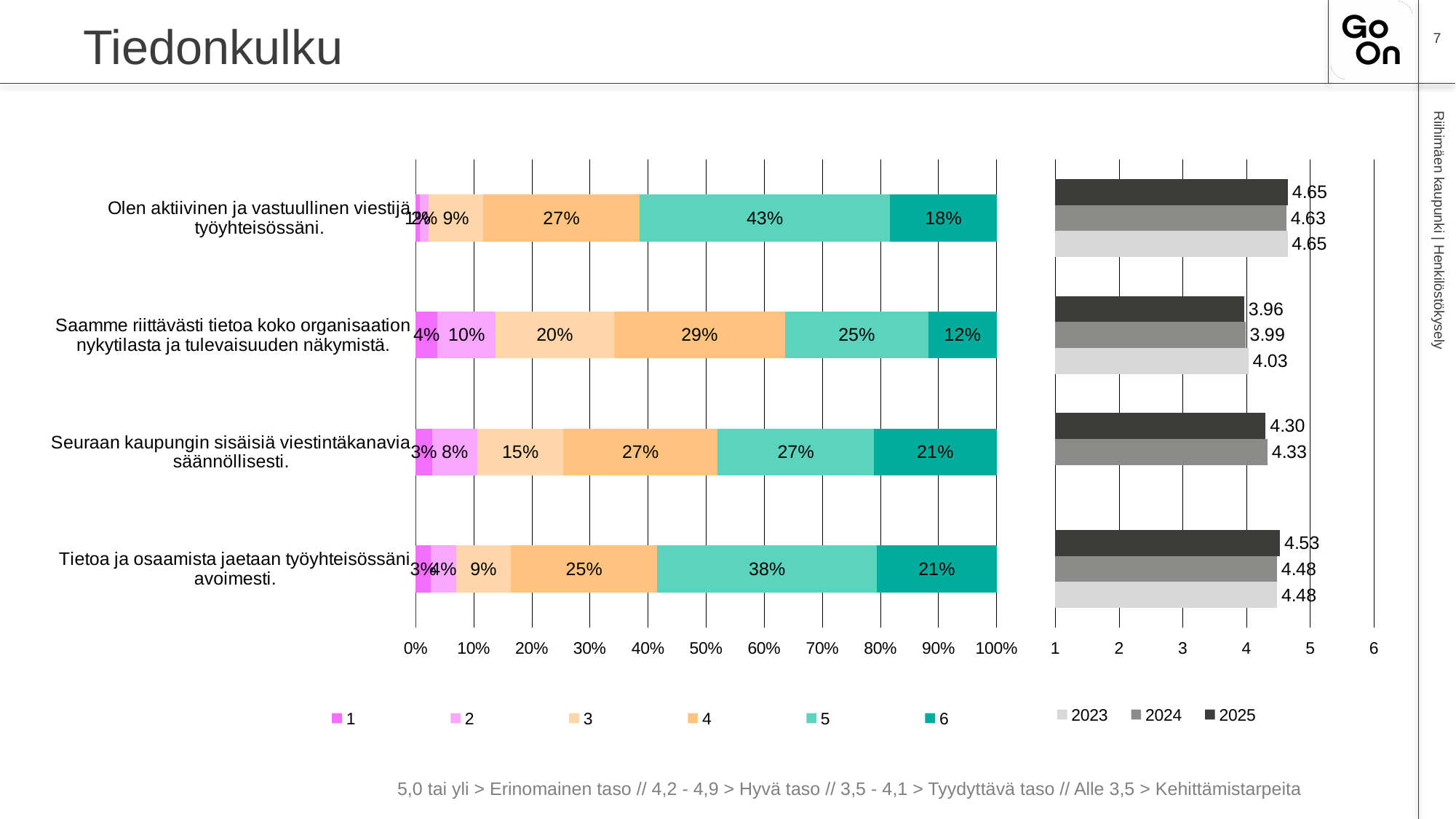
In the right bar chart, what is the 2025 value for "Saamme riittävästi tietoa koko organisaation nykytilasta ja tulevaisuuden näkymistä"? 3.96 In the left stacked bar chart, what percentage gave a rating of 6 for "Saamme riittävästi tietoa koko organisaation nykytilasta ja tulevaisuuden näkymistä"? 12% In the right bar chart, what is the difference between the 2025 and 2024 values for "Tietoa ja osaamista jaetaan työyhteisössäni avoimesti"? 0.05 In the left stacked bar chart, for "Saamme riittävästi tietoa koko organisaation nykytilasta ja tulevaisuuden näkymistä", which rating has the larger share: 4 or 5? 4 How many series does the legend of the left stacked bar chart list? 6 How many series does the legend of the right bar chart list? 3 In the left stacked bar chart, which statement has the highest share of rating 5? Olen aktiivinen ja vastuullinen viestijä työyhteisössäni. In the right bar chart, which statement has the lowest 2025 value? Saamme riittävästi tietoa koko organisaation nykytilasta ja tulevaisuuden näkymistä. In the left stacked bar chart, what percentage of respondents gave a rating of 5 for "Olen aktiivinen ja vastuullinen viestijä työyhteisössäni"? 43% In the right bar chart, what is the 2023 value for "Tietoa ja osaamista jaetaan työyhteisössäni avoimesti"? 4.48 How many statements (categories) are shown in the left stacked bar chart? 4 What kind of chart is the left chart on the slide? Stacked bar chart